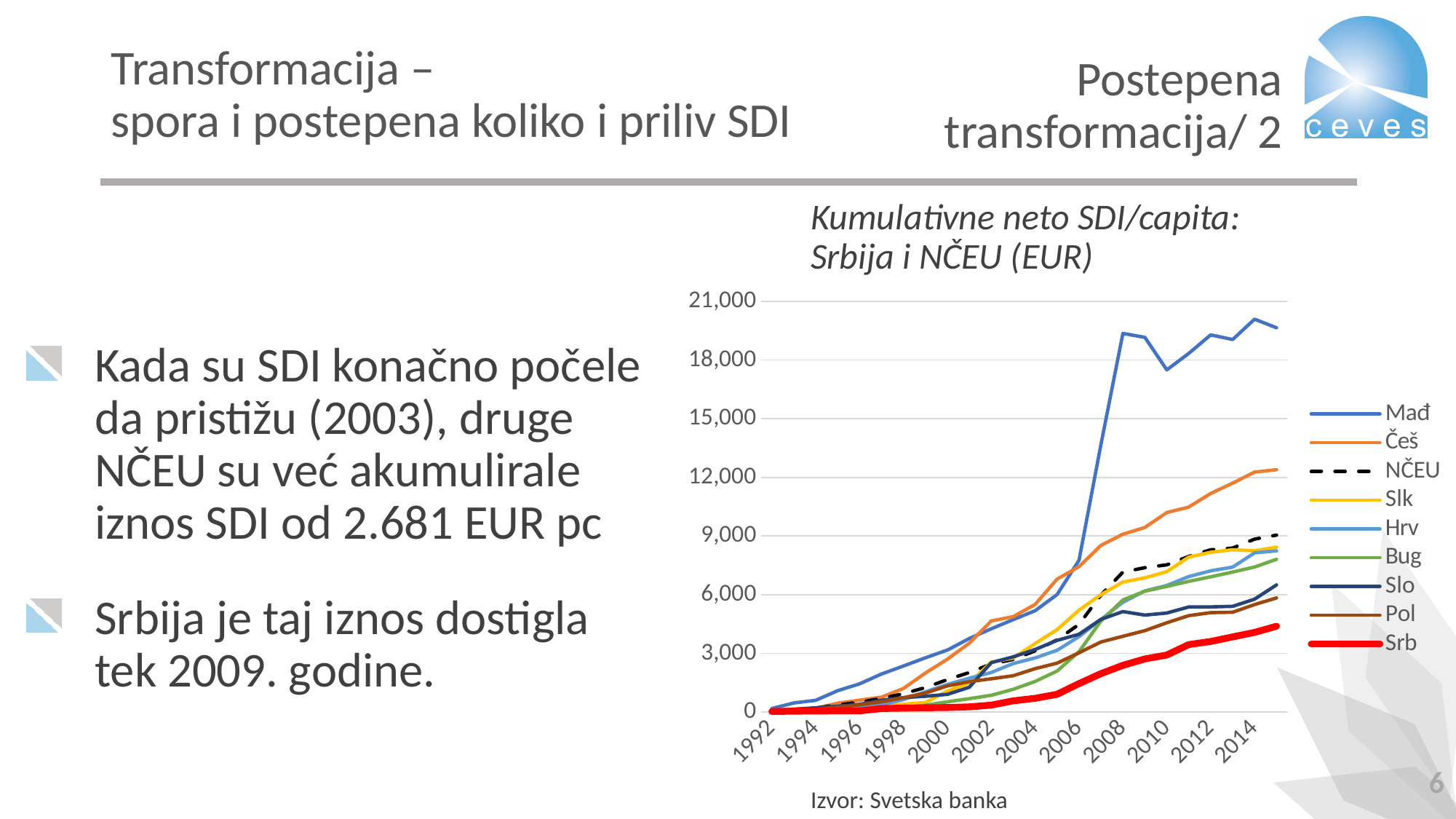
What kind of chart is shown on the slide? line chart Is the value for Srb in 2014 greater or less than 6,000? less Is the value for Mađ in 2008 greater or less than 18,000? greater Which series is drawn as a black dashed line? NČEU Which series has the lowest value at the right end of the chart (2014)? Srb What is the title of the chart? Kumulativne neto SDI/capita: Srbija i NČEU (EUR) Is the value for Srb in 2014 greater or less than 3,000? greater How many series does the legend of the chart list? 9 Which series has the highest value at the right end of the chart (2014)? Mađ Which is larger in 2014, the value for Češ or the value for Slk? Češ Do the values for Srb generally rise or fall from 1992 to 2014? rise